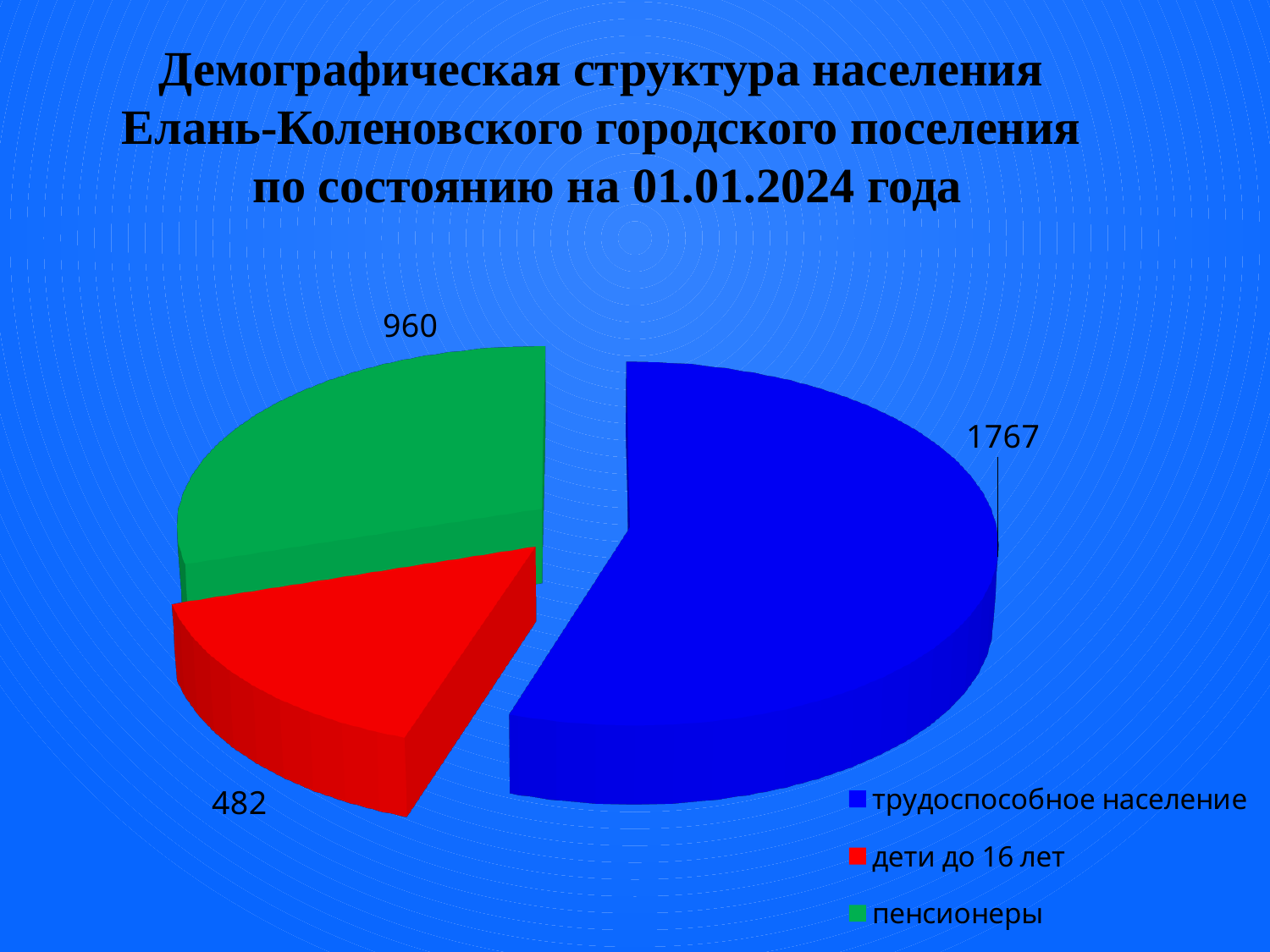
Which category has the largest slice of the pie? трудоспособное население What is the difference between the values for трудоспособное население and пенсионеры? 807 Which category has the smallest slice of the pie? дети до 16 лет What is the value for пенсионеры? 960 What is the value for трудоспособное население? 1767 What is the value for дети до 16 лет? 482 Which colour represents пенсионеры in the pie chart? Green How many categories does the pie chart have? 3 What type of chart is shown on the slide? Pie chart What is the total of all slices in the pie chart? 3209 What is the difference between the values for пенсионеры and дети до 16 лет? 478 Which is larger, the value for пенсионеры or the value for дети до 16 лет? пенсионеры